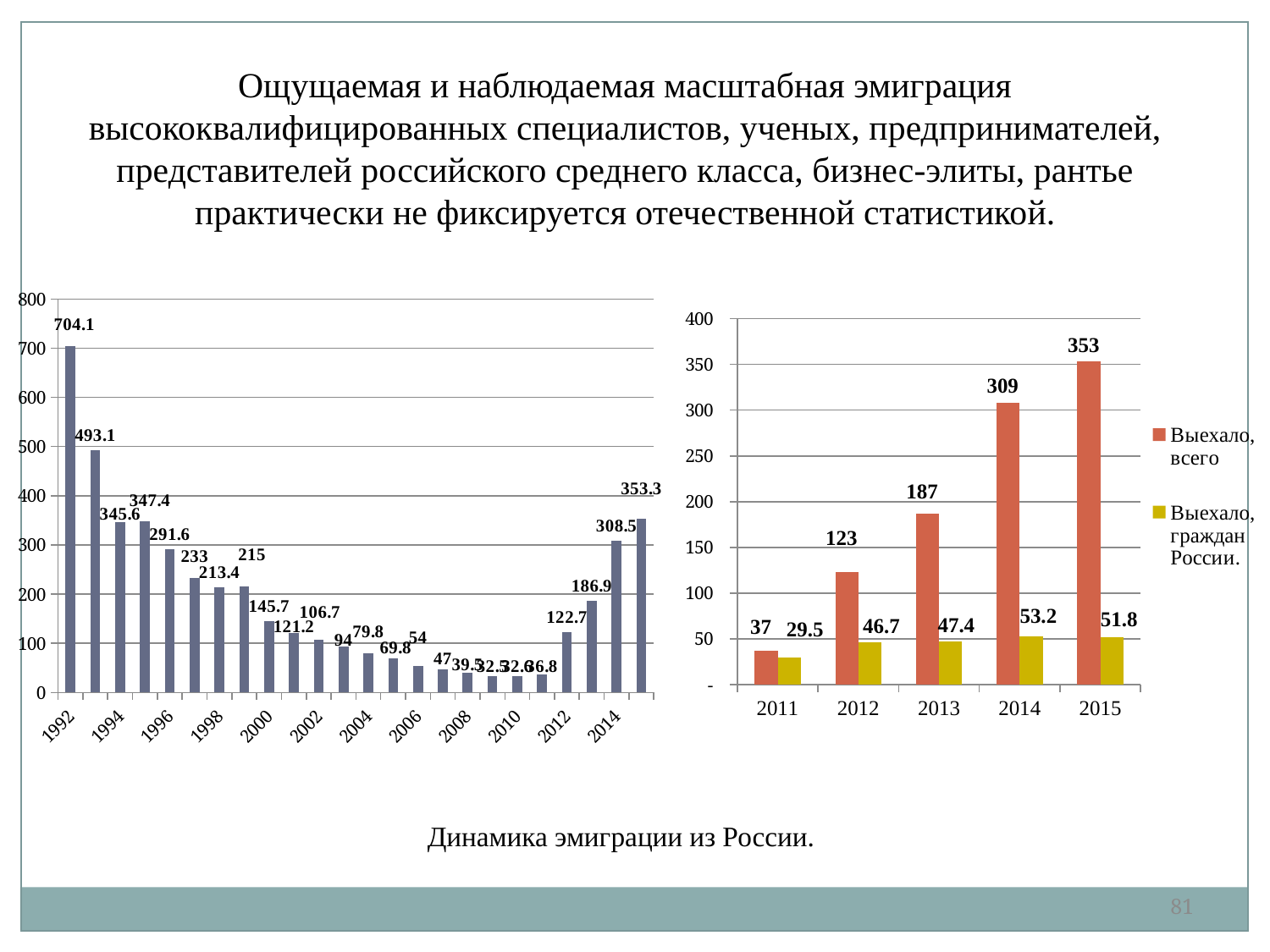
In the right chart (2011–2015), does the value of 'Выехало, всего' rise or fall from 2011 to 2015? rise In the right chart (2011–2015), how many series does the legend list? 2 In the right chart (2011–2015), which year has the highest value for 'Выехало, всего'? 2015 In the right chart (2011–2015), what is the value of 'Выехало, граждан России.' for 2012? 46.7 What type of chart is the left chart (1992–2015)? bar chart In the right chart (2011–2015), what is the value of 'Выехало, всего' for 2014? 309 In the left chart (1992–2015), which is larger, the value for 1996 or the value for 2012? 1996 In the left chart (1992–2015), what is the value for 2014? 308.5 In the right chart (2011–2015), what is the difference between 'Выехало, всего' and 'Выехало, граждан России.' in 2015? 301.2 In the left chart (1992–2015), which year has the highest value? 1992 In the left chart (1992–2015), what is the value for 1992? 704.1 In the right chart (2011–2015), which year has the lowest value for 'Выехало, граждан России.'? 2011